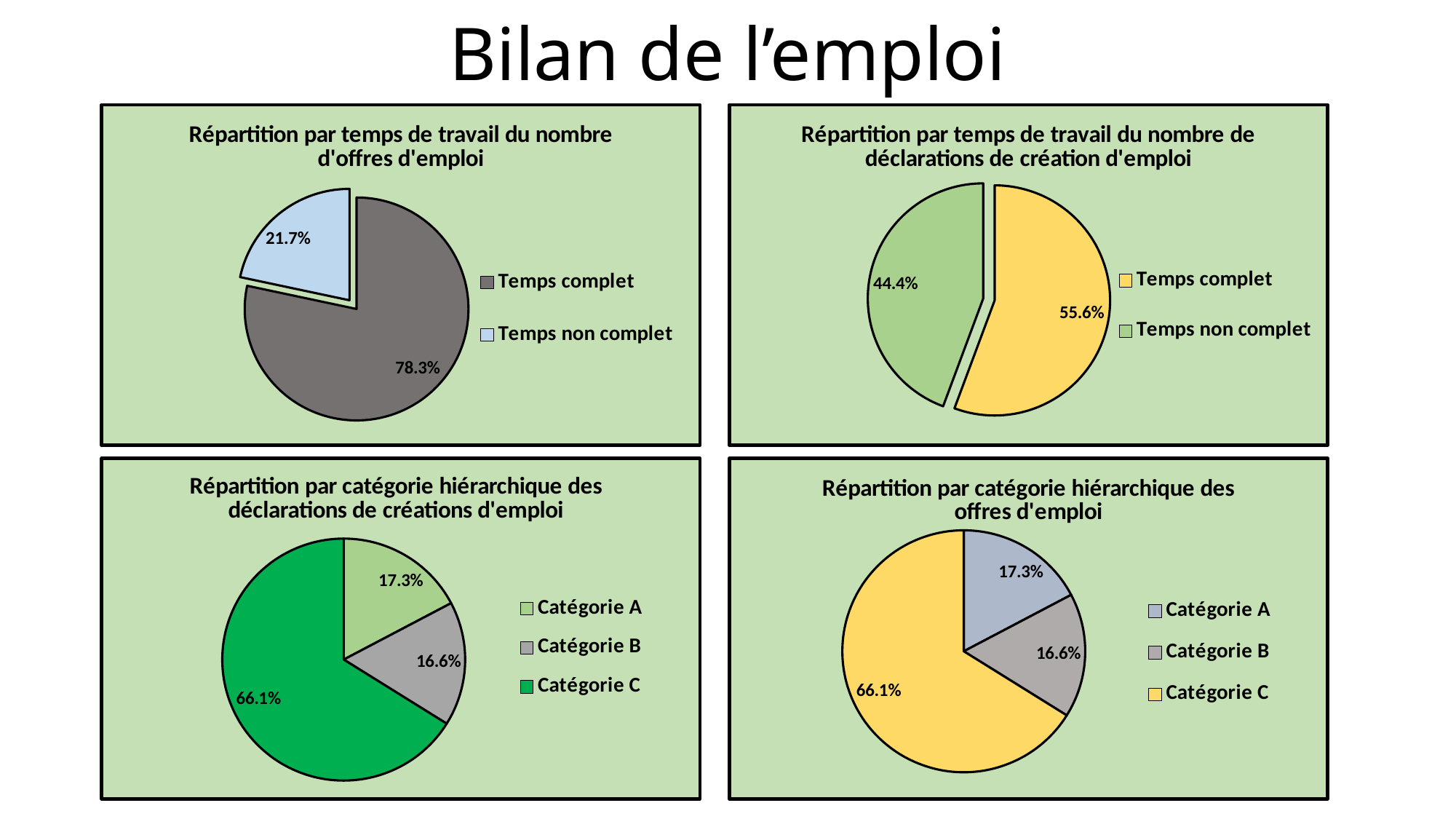
How many categories does the legend of the bottom-left chart (catégorie hiérarchique des déclarations de créations d'emploi) list? 3 In the bottom-right chart (Répartition par catégorie hiérarchique des offres d'emploi), which category has the largest slice? Catégorie C In the top-left chart (offres d'emploi by temps de travail), what is the difference between the Temps complet and Temps non complet shares? 56.6% In the top-left chart (Répartition par temps de travail du nombre d'offres d'emploi), what share is Temps complet? 78.3% In the top-right chart (déclarations de création d'emploi by temps de travail), which slice is larger, Temps complet or Temps non complet? Temps complet In the top-left chart (Répartition par temps de travail du nombre d'offres d'emploi), what share is Temps non complet? 21.7% In the top-right chart (Répartition par temps de travail du nombre de déclarations de création d'emploi), what share is Temps non complet? 44.4% What kind of chart is the top-left chart (Répartition par temps de travail du nombre d'offres d'emploi)? Pie chart